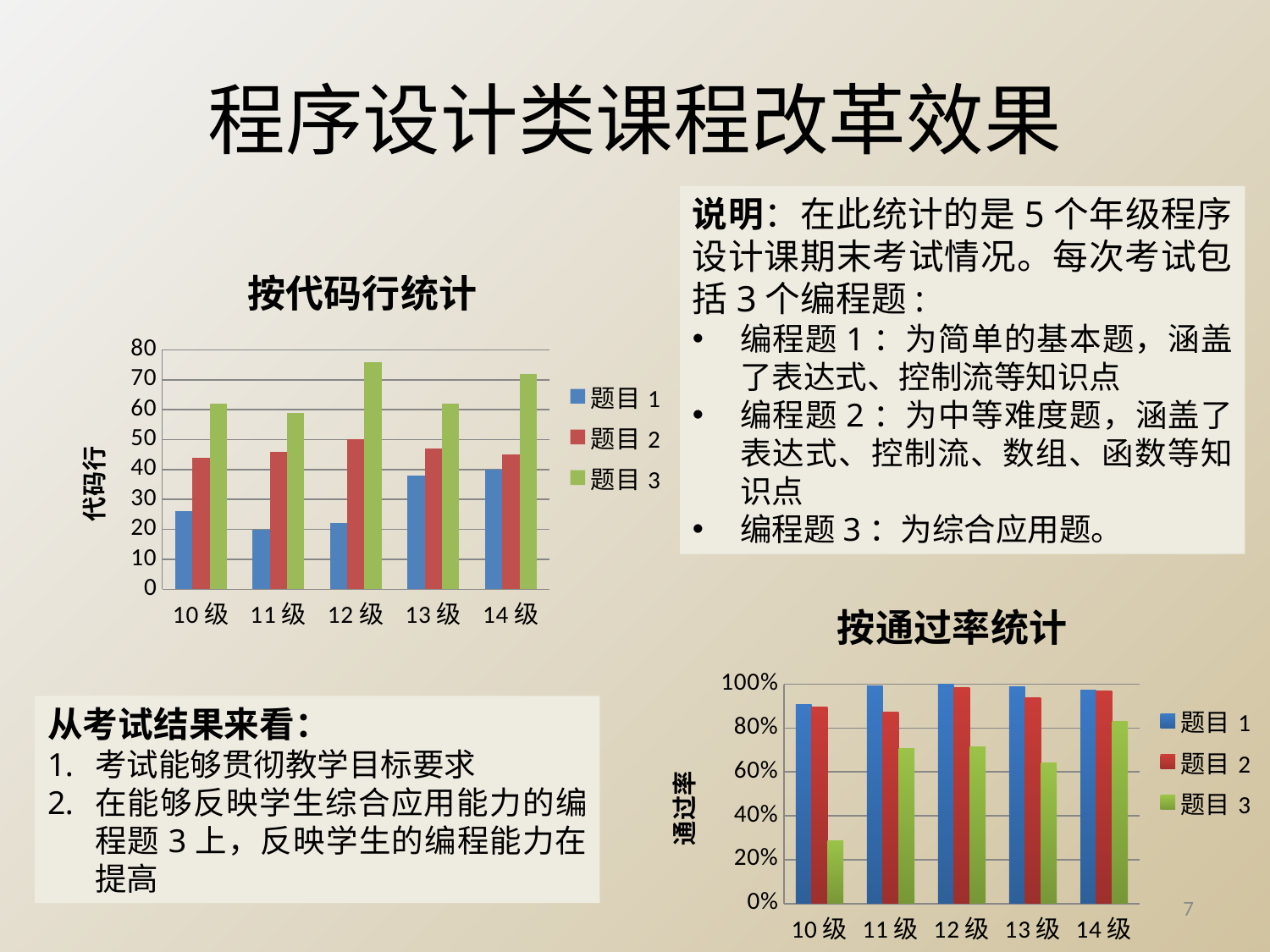
In the chart titled 按通过率统计, is the value for 题目 3 at 10 级 greater or less than 40%? less In the chart titled 按代码行统计, which is larger: the 题目 1 value for 10 级 or for 14 级? 14 级 In the chart titled 按代码行统计, how many series does the legend list? 3 In the chart titled 按代码行统计, which grade has the highest bar for 题目 3? 12 级 In the chart titled 按通过率统计, which grade has the lowest bar for 题目 3? 10 级 What kind of chart is the chart titled 按代码行统计? bar chart In the chart titled 按通过率统计, how many series does the legend list? 3 What is the y-axis title of the chart titled 按通过率统计? 通过率 In the chart titled 按代码行统计, how many grade categories are shown on the x axis? 5 In the chart titled 按通过率统计, is the value for 题目 3 at 14 级 greater or less than 80%? greater In the chart titled 按代码行统计, is the value for 题目 1 at 10 级 greater or less than 30? less